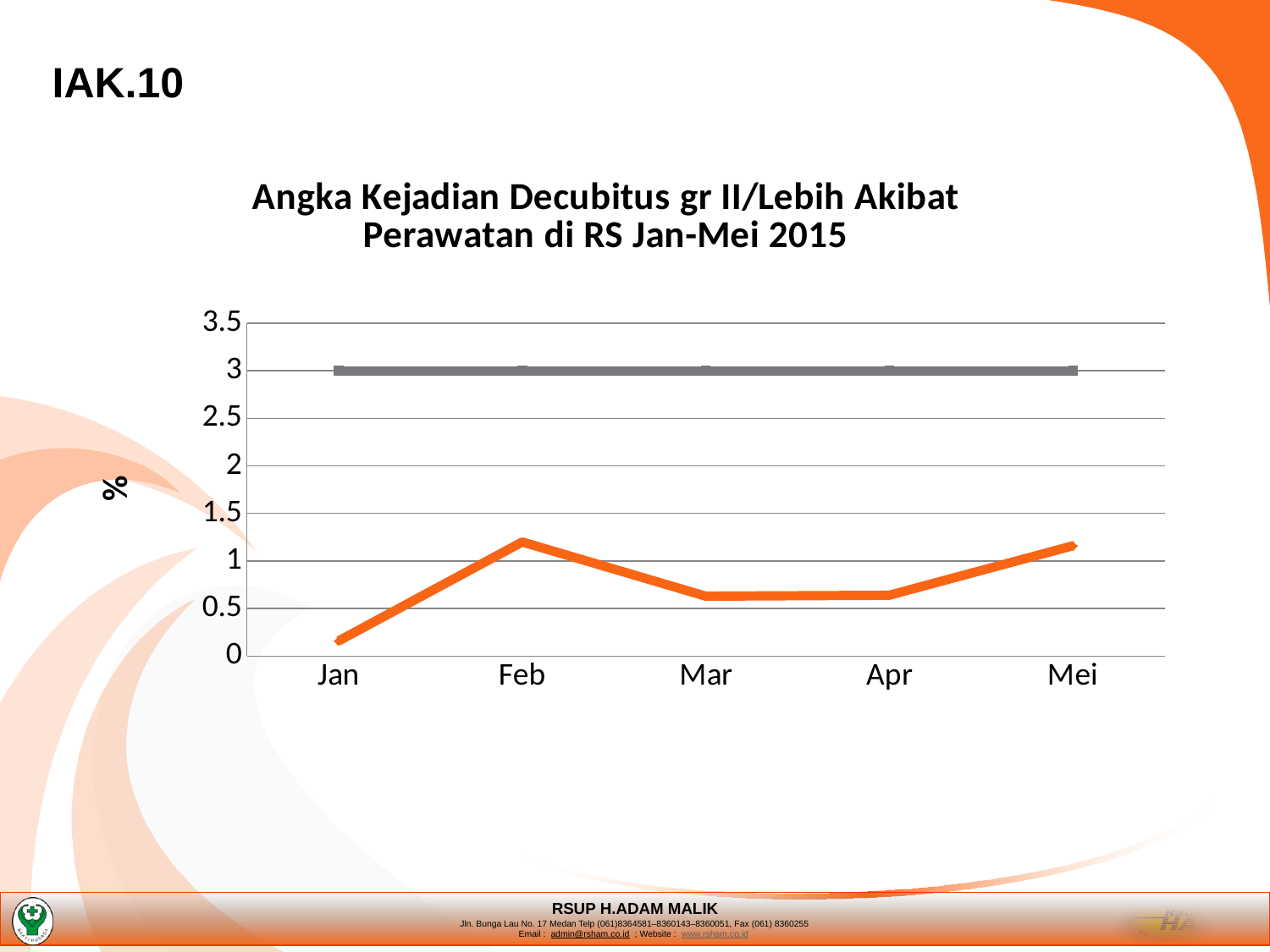
What kind of chart is shown on the slide? line chart What is the title of the chart? Angka Kejadian Decubitus gr II/Lebih Akibat Perawatan di RS Jan-Mei 2015 Which month has the larger value on the orange line, Feb or Mar? Feb Is the value of the orange line for Feb greater or less than 1? greater Is the value of the orange line for Mei greater or less than 1? greater Which month has the lowest value on the orange line? Jan Is the value of the orange line for Mar greater or less than 1? less Which month has the larger value on the orange line, Jan or Apr? Apr Does the orange line rise or fall from Jan to Feb? rise What is the label on the vertical axis of the chart? % How many months are shown on the x axis of the chart? 5